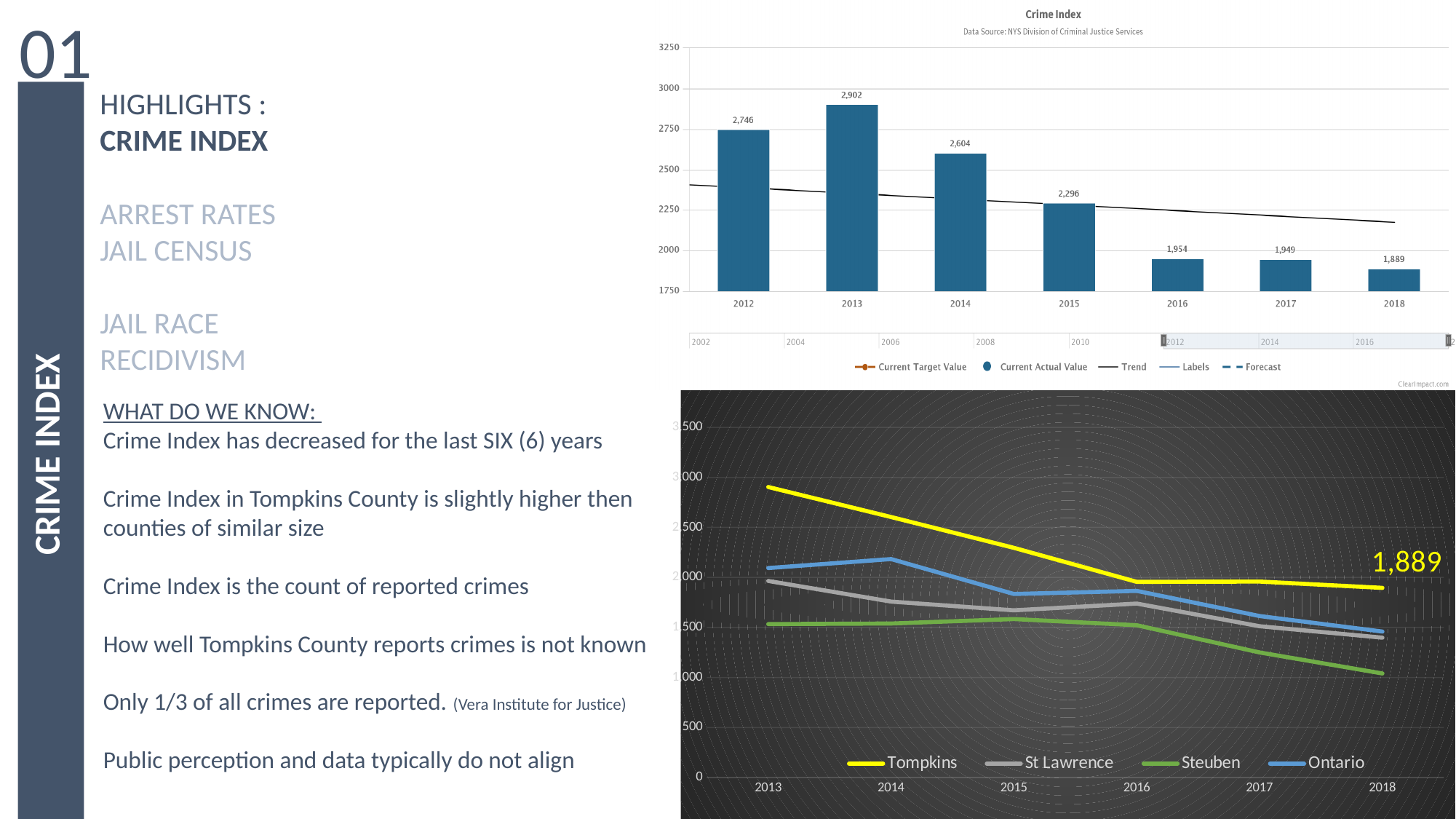
In the bottom line chart, is the value for Steuben in 2018 greater or less than 1,500? less In the bottom line chart, what is the labelled value for Tompkins in 2018? 1,889 What kind of chart is the bottom chart comparing Tompkins, St Lawrence, Steuben and Ontario? line chart In the top 'Crime Index' bar chart, do the values rise or fall from 2013 to 2018? fall In the top 'Crime Index' bar chart, what is the value for 2013? 2,902 In the top 'Crime Index' bar chart, which year has the highest value? 2013 In the top 'Crime Index' bar chart, which year has the lowest value? 2018 In the top 'Crime Index' bar chart, what is the difference between the 2013 value and the 2018 value? 1,013 How many years are shown as bars in the top 'Crime Index' bar chart? 7 In the top 'Crime Index' bar chart, what is the value for 2016? 1,954 How many series does the legend of the bottom line chart list? 4 In the top 'Crime Index' bar chart, which is larger, the value for 2012 or the value for 2014? 2012